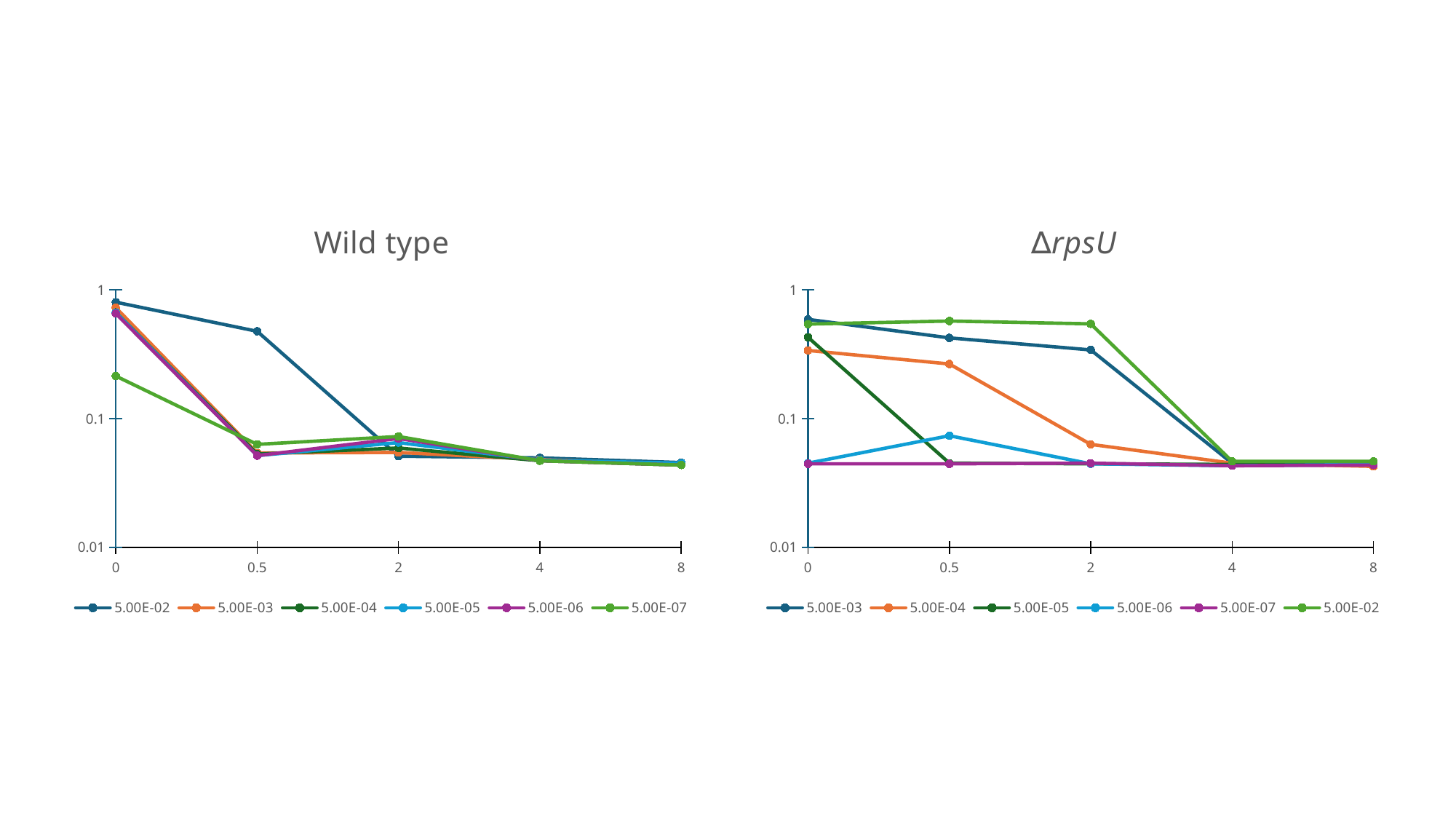
What kind of chart is the Wild type chart? line chart On the Wild type chart, is the value for 5.00E-02 at x = 8 greater or less than 0.1? less On the ΔrpsU chart, at x = 2, which is larger: 5.00E-02 or 5.00E-04? 5.00E-02 On the Wild type chart, is the value for 5.00E-07 at x = 0 greater or less than 0.1? greater How many x-axis points are plotted on the Wild type chart? 5 On the Wild type chart, is the value for 5.00E-02 at x = 0.5 greater or less than 0.1? greater How many series does the legend of the ΔrpsU chart list? 6 On the Wild type chart, does the 5.00E-02 series rise or fall from x = 0 to x = 8? fall What is the title of the chart on the right? ΔrpsU On the Wild type chart, which series has the lowest value at x = 0? 5.00E-07